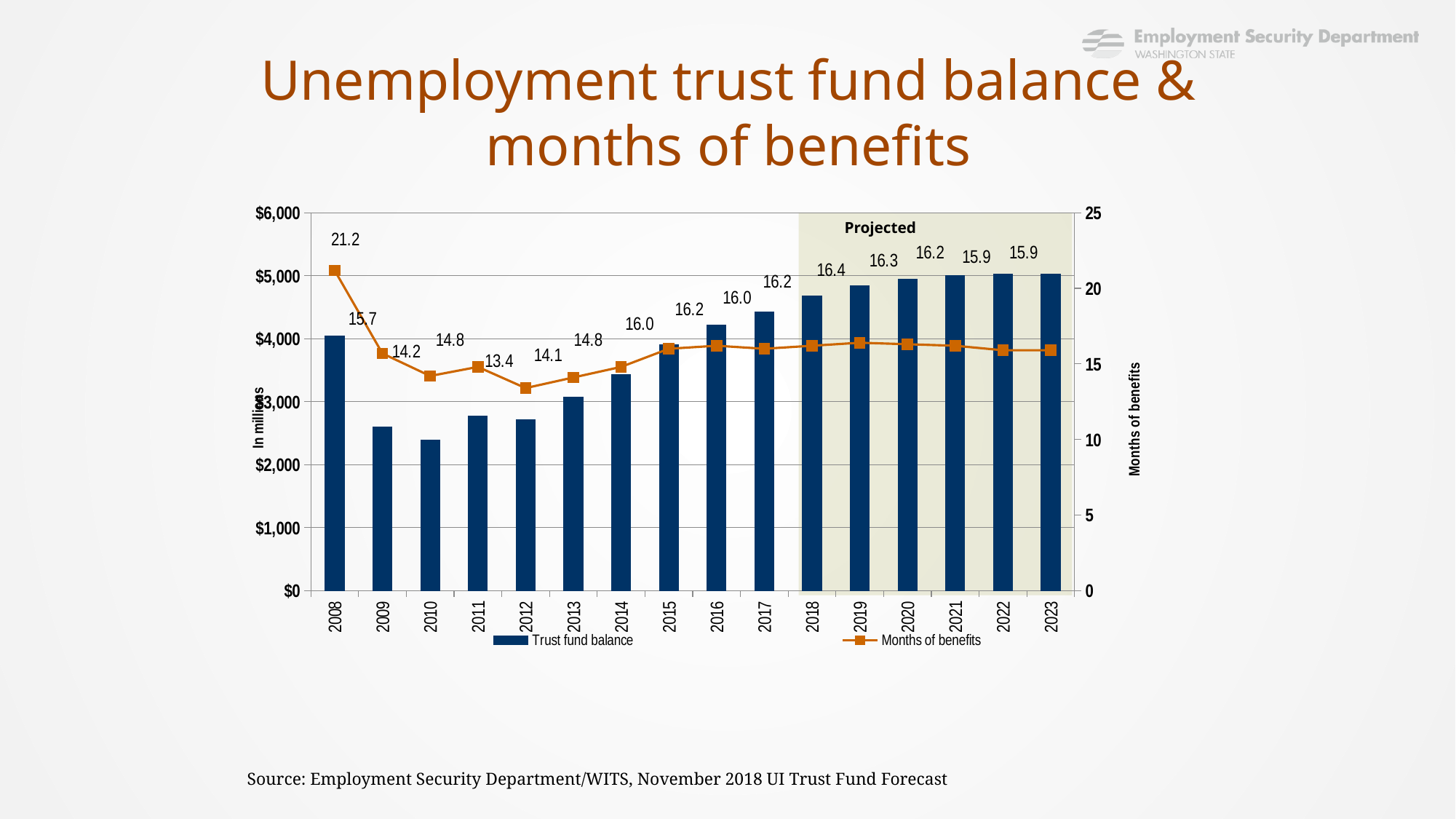
What type of chart is shown on the slide? Combined bar and line chart What is the difference in months of benefits between 2008 and 2009? 5.5 Which year has the lowest months of benefits value? 2012 How many series does the legend list? 2 Which year has the lowest trust fund balance? 2010 What is the months of benefits value for 2012? 13.4 What is the months of benefits value for 2008? 21.2 Is the trust fund balance for 2010 greater or less than $3,000? less Which year has the highest months of benefits value? 2008 How many years are shown on the x axis? 16 What is the months of benefits value for 2019? 16.4 Which years are shaded as projected in the chart? 2018 to 2023